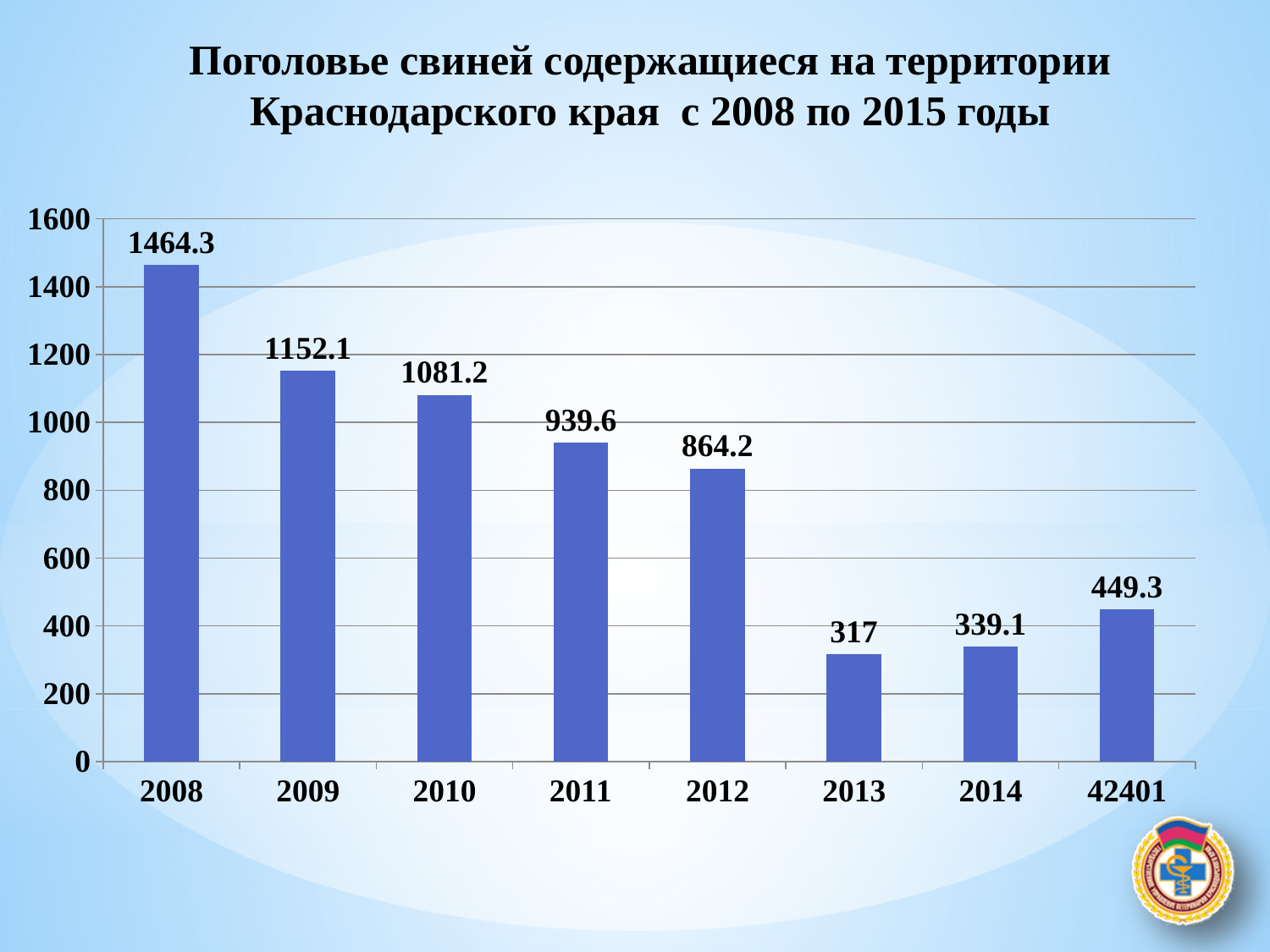
Which is larger, the value for 2012 or the value for 2014? 2012 What is the value for 2008? 1464.3 What is the difference between the values for 2014 and 2013? 22.1 What is the value for 2013? 317 Do the values generally rise or fall from 2008 to 2013? Fall Which category has the lowest value? 2013 How many categories are shown on the x axis? 8 What is the value for 2011? 939.6 Which category has the highest value? 2008 What is the difference between the values for 2008 and 2009? 312.2 What kind of chart is shown on the slide? Bar chart What is the value for the category labelled 42401? 449.3